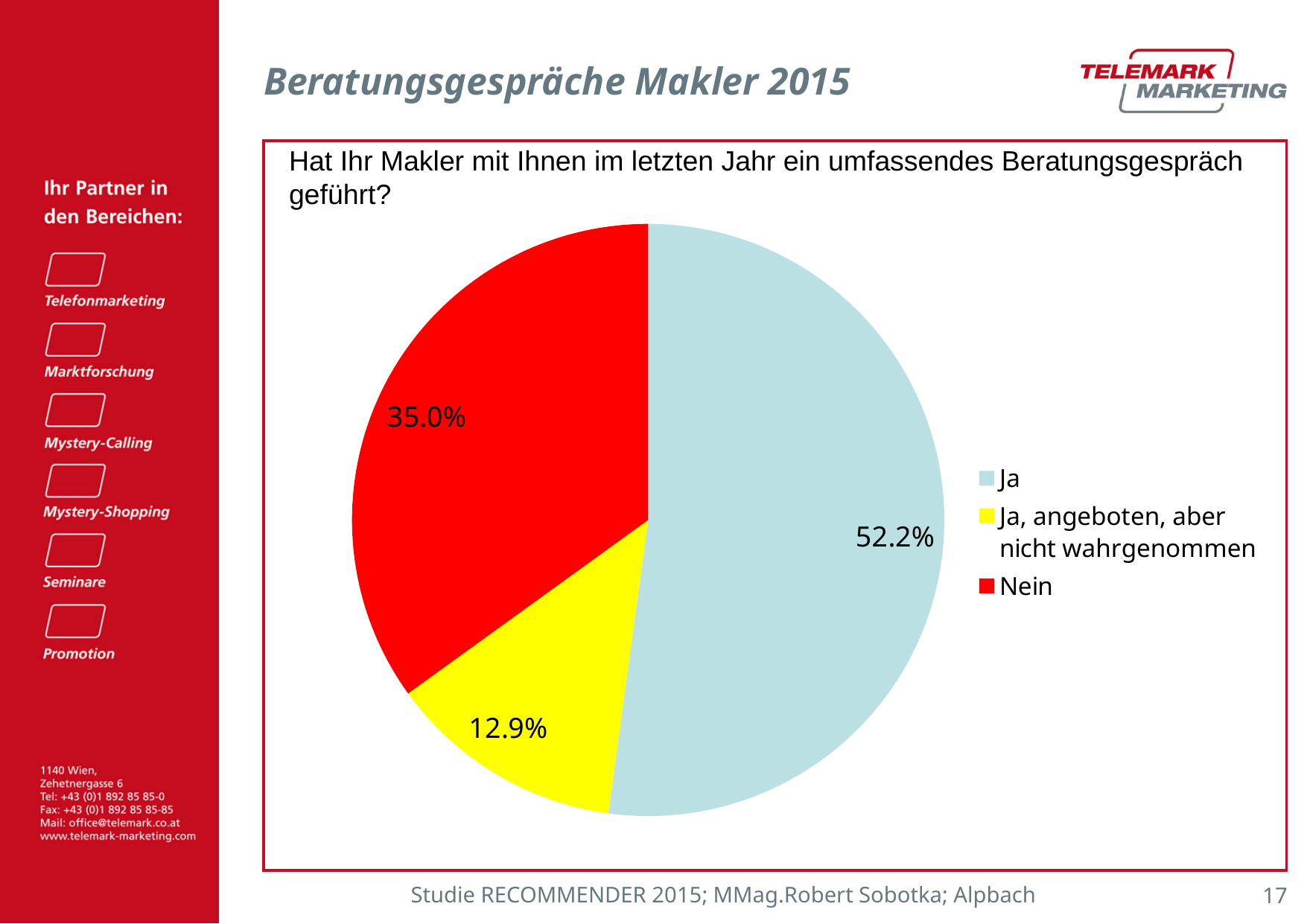
What colour is the "Nein" slice? red What share of respondents answered "Ja"? 52.2% Which answer has the largest slice of the pie? Ja What share of respondents answered "Nein"? 35.0% What kind of chart is shown on the slide? pie chart Which is larger, the "Nein" slice or the "Ja, angeboten, aber nicht wahrgenommen" slice? Nein Which answer has the smallest slice of the pie? Ja, angeboten, aber nicht wahrgenommen How many entries does the legend list? 3 What share of respondents answered "Ja, angeboten, aber nicht wahrgenommen"? 12.9% How many slices does the pie chart have? 3 What is the difference in percentage points between the "Ja" and "Nein" slices? 17.2 percentage points What question is the pie chart answering, as shown above the chart? Hat Ihr Makler mit Ihnen im letzten Jahr ein umfassendes Beratungsgespräch geführt?